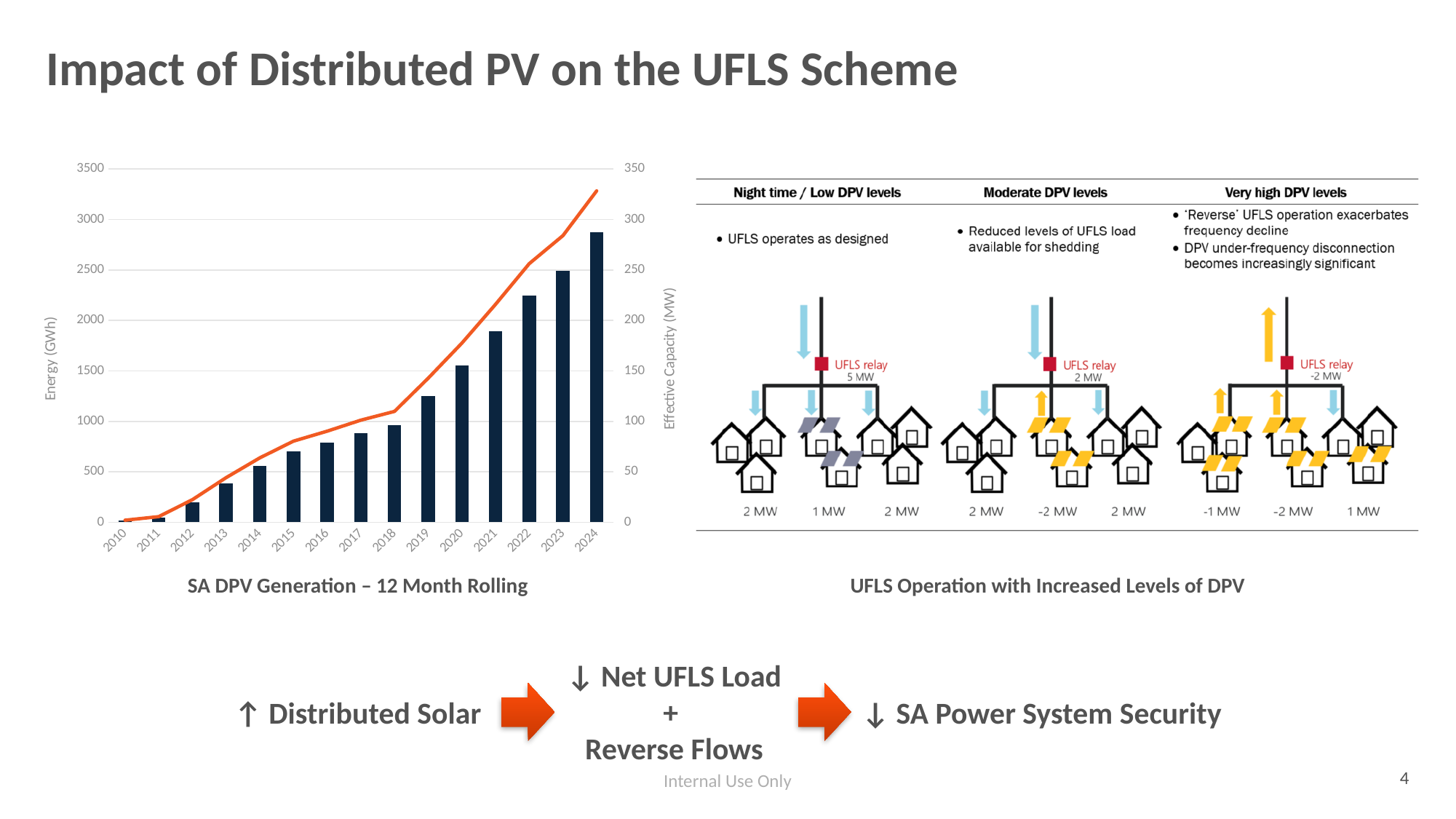
In the SA DPV Generation chart, is the bar value for 2022 greater or less than 2000? greater In the SA DPV Generation chart, which year has the larger bar, 2021 or 2023? 2023 In the SA DPV Generation chart, what is the label of the left vertical axis? Energy (GWh) In the SA DPV Generation chart, which year has the tallest bar? 2024 In the SA DPV Generation chart, do the bar values rise or fall from 2010 to 2024? rise What is the title of the chart on the left of the slide? SA DPV Generation – 12 Month Rolling In the SA DPV Generation chart, is the bar value for 2015 greater or less than 1000? less In the SA DPV Generation chart, which year has the shortest bar? 2010 In the SA DPV Generation chart, is the bar value for 2024 greater or less than 2500? greater How many years are shown on the x axis of the SA DPV Generation chart? 15 What kind of chart is the SA DPV Generation – 12 Month Rolling chart? bar and line chart